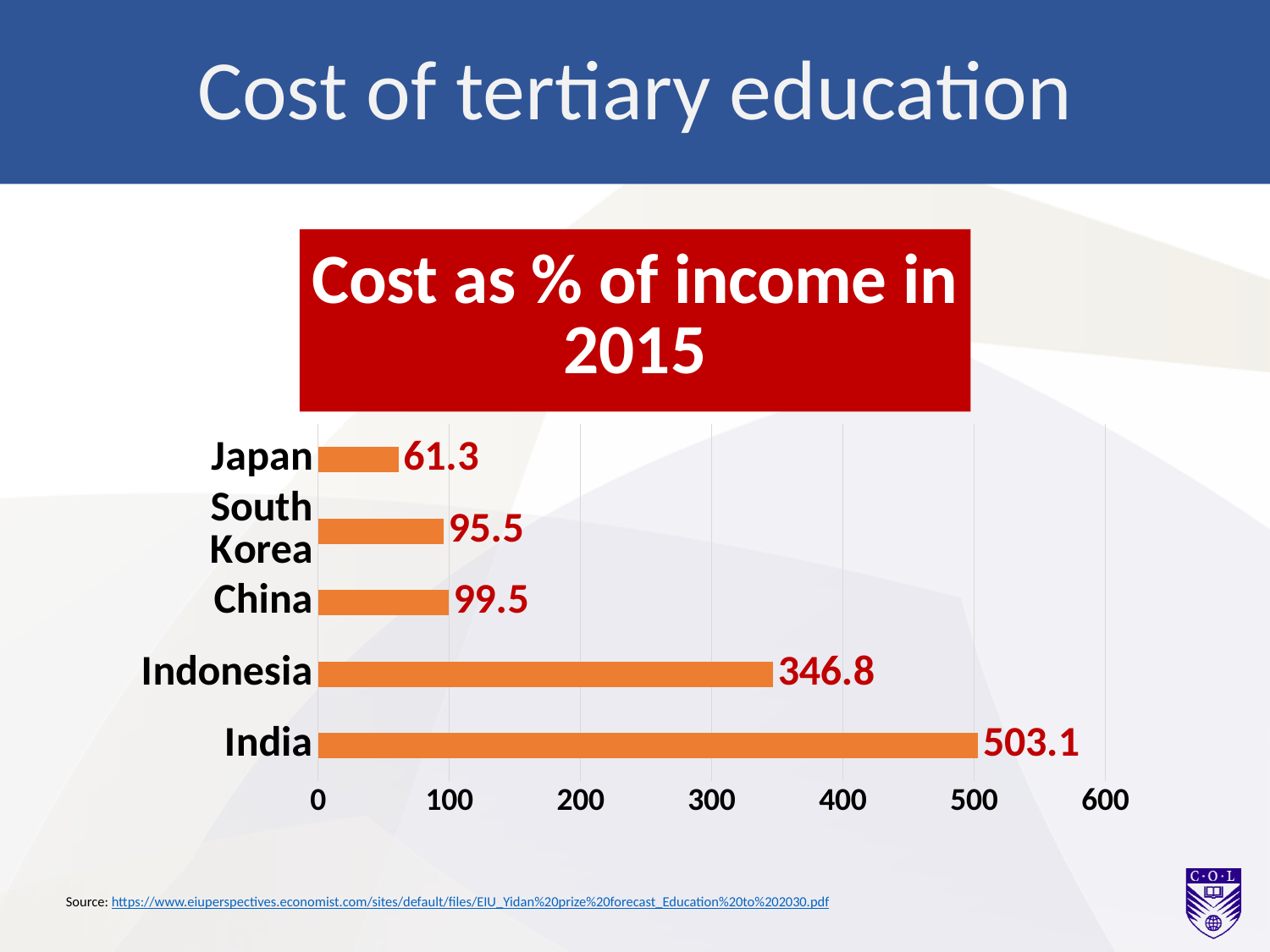
How many countries are shown in the chart? 5 What is the difference between the values for India and Indonesia? 156.3 What is the title of the chart? Cost as % of income in 2015 What is the value for Japan? 61.3 Which country has the highest value? India What is the value for India? 503.1 What is the value for South Korea? 95.5 What kind of chart is shown on the slide? Bar chart What is the value for Indonesia? 346.8 Which is larger, the value for Indonesia or the value for China? Indonesia What is the difference between the values for China and Japan? 38.2 Which country has the lowest value? Japan